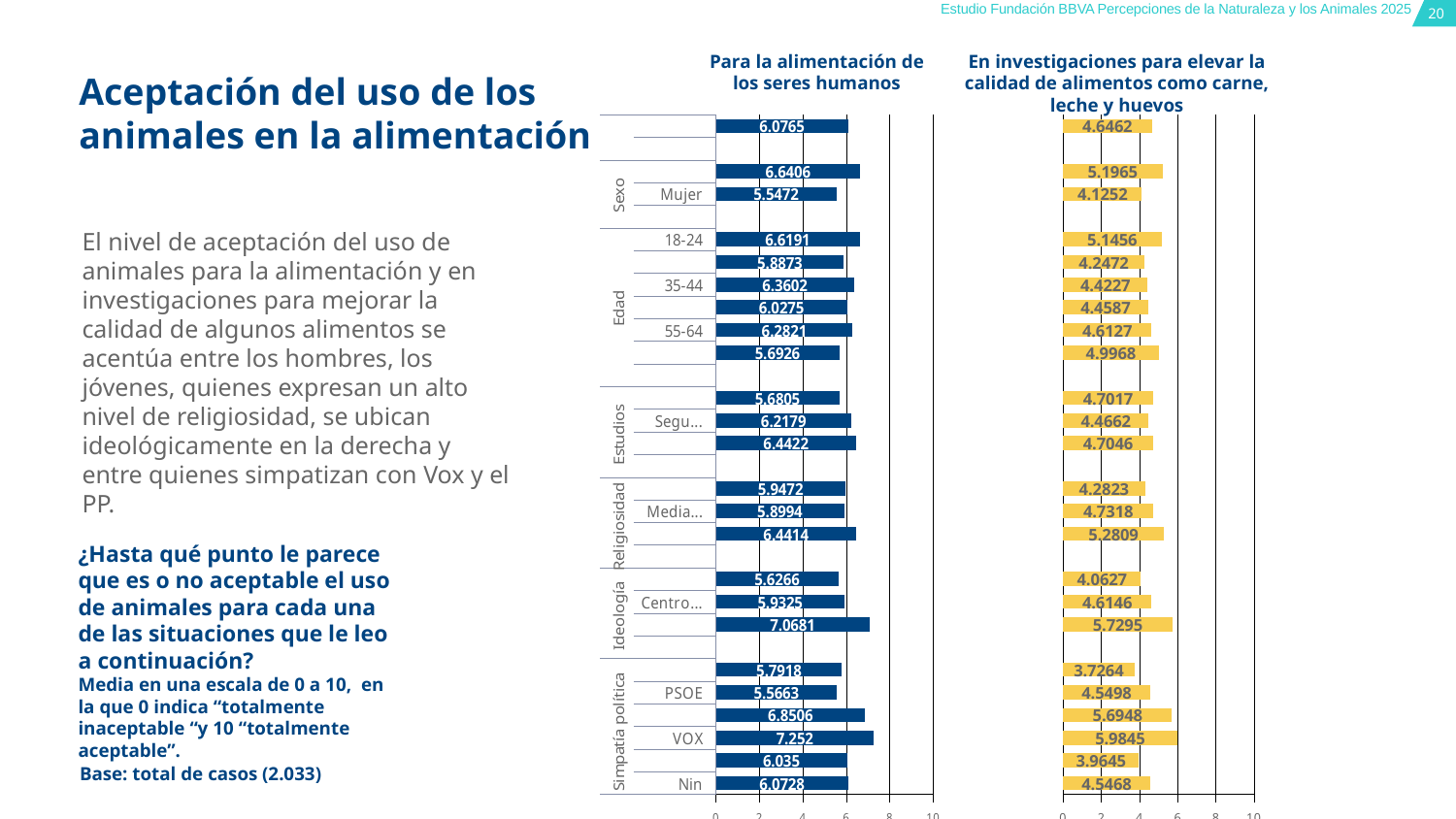
In the chart 'Para la alimentación de los seres humanos', what is the value for 18-24? 6.6191 In the chart 'Para la alimentación de los seres humanos', which is larger, the value for 18-24 or for 35-44? 18-24 In the chart 'En investigaciones para elevar la calidad de alimentos como carne, leche y huevos', which labelled category has the highest value? VOX In the chart 'En investigaciones para elevar la calidad de alimentos como carne, leche y huevos', what is the value for 55-64? 4.6127 In the chart 'Para la alimentación de los seres humanos', which labelled category has the highest value? VOX In the chart 'En investigaciones para elevar la calidad de alimentos como carne, leche y huevos', what is the value for PSOE? 4.5498 What kind of chart is 'Para la alimentación de los seres humanos'? bar chart In the chart 'Para la alimentación de los seres humanos', what is the value for Mujer? 5.5472 In the chart 'Para la alimentación de los seres humanos', what is the difference between the values for VOX and PSOE? 1.6857 In the chart 'En investigaciones para elevar la calidad de alimentos como carne, leche y huevos', is the value for Mujer greater or less than 6? less In the chart 'En investigaciones para elevar la calidad de alimentos como carne, leche y huevos', what is the value for VOX? 5.9845 In the chart 'Para la alimentación de los seres humanos', is the value for VOX greater or less than 6? greater